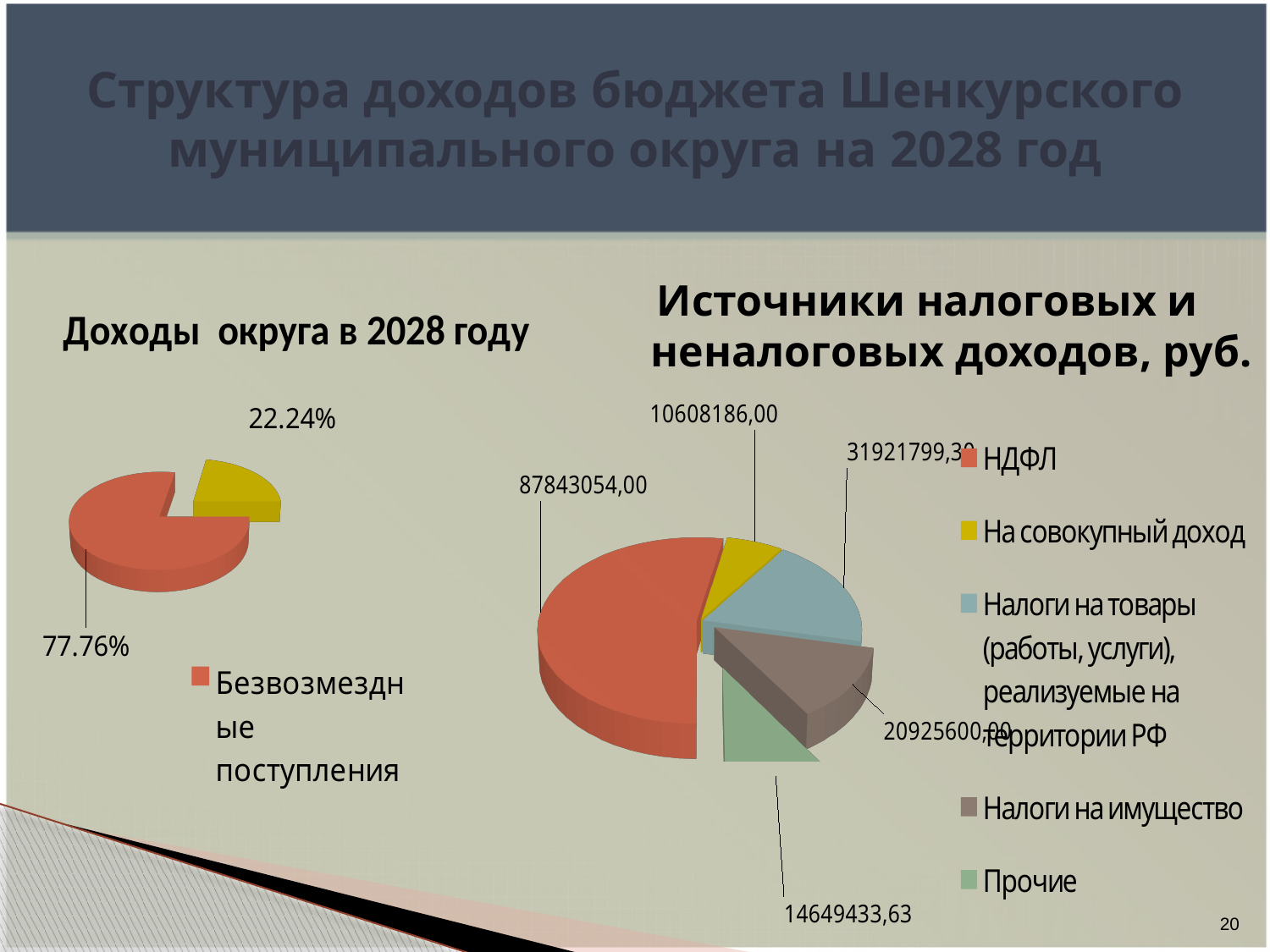
How many entries does the legend of the right chart "Источники налоговых и неналоговых доходов, руб." list? 5 In the right chart "Источники налоговых и неналоговых доходов, руб.", which category has the largest value? НДФЛ In the right chart "Источники налоговых и неналоговых доходов, руб.", what is the value for Прочие? 14649433,63 How many slices does the left chart "Доходы округа в 2028 году" have? 2 In the left chart "Доходы округа в 2028 году", which category has the largest slice? Безвозмездные поступления In the right chart "Источники налоговых и неналоговых доходов, руб.", what is the value for НДФЛ? 87843054,00 In the right chart "Источники налоговых и неналоговых доходов, руб.", what is the difference between the values for НДФЛ and На совокупный доход? 77234868,00 In the right chart "Источники налоговых и неналоговых доходов, руб.", what is the value for Налоги на имущество? 20925600,00 In the left chart "Доходы округа в 2028 году", what share does Безвозмездные поступления have? 77.76% What kind of chart is the left chart titled "Доходы округа в 2028 году"? pie chart In the right chart "Источники налоговых и неналоговых доходов, руб.", what is the value for На совокупный доход? 10608186,00 In the right chart "Источники налоговых и неналоговых доходов, руб.", which category has the smallest value? На совокупный доход